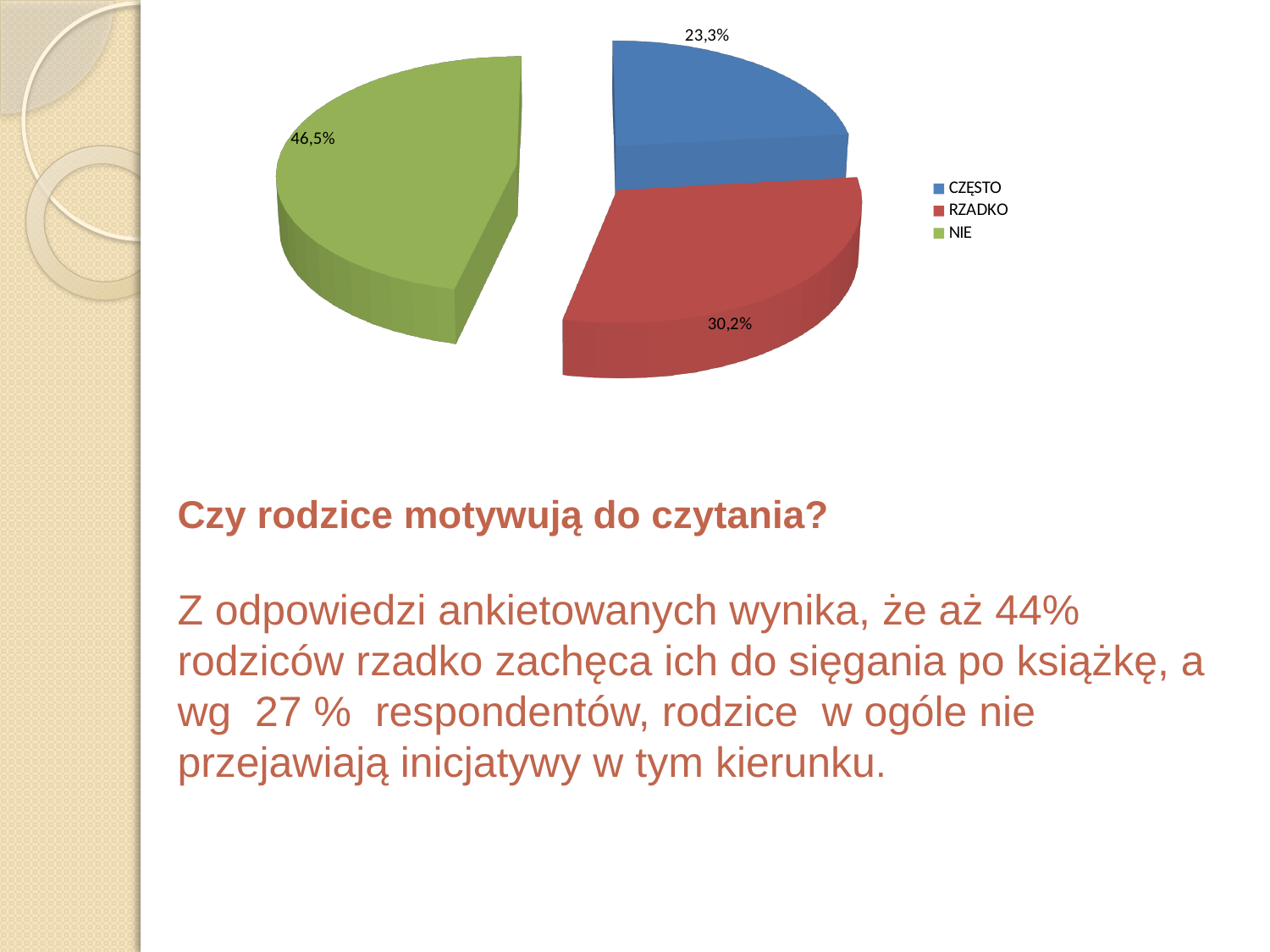
What kind of chart is shown on the slide? pie chart What percentage of the pie is the RZADKO slice? 30,2% What colour is the NIE slice in the pie chart? green What is the difference in percentage points between the RZADKO slice and the CZĘSTO slice? 6,9 How many slices does the pie chart have? 3 What is the difference in percentage points between the NIE slice and the RZADKO slice? 16,3 How many entries does the legend list? 3 Which category has the smallest share of the pie? CZĘSTO What percentage of the pie is the CZĘSTO slice? 23,3% Which is larger, the RZADKO slice or the CZĘSTO slice? RZADKO What percentage of the pie is the NIE slice? 46,5% Which category has the largest share of the pie? NIE